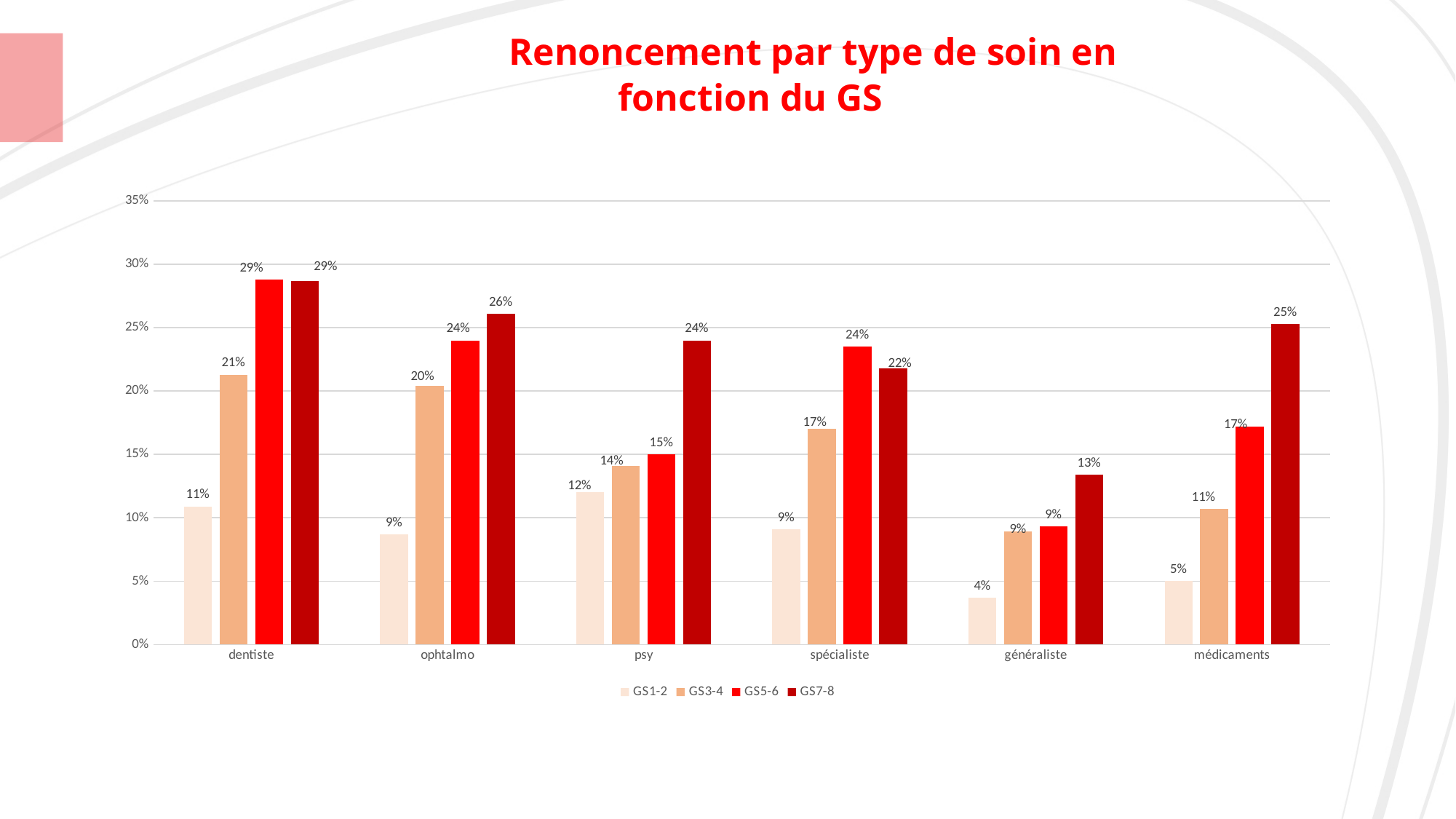
What is the difference between the GS7-8 and GS1-2 values in the psy category? 12% How many series does the legend list? 4 Which category has the lowest value for GS7-8? généraliste What is the title of the chart? Renoncement par type de soin en fonction du GS Which category has the highest value for GS1-2? psy How many care-type categories are shown on the x axis? 6 In the spécialiste category, which is larger: the GS5-6 value or the GS7-8 value? GS5-6 What kind of chart is shown on the slide? Bar chart What is the value for GS7-8 in the médicaments category? 25% What is the value for GS3-4 in the ophtalmo category? 20% What is the value for GS5-6 in the spécialiste category? 24% What is the value for GS1-2 in the généraliste category? 4%